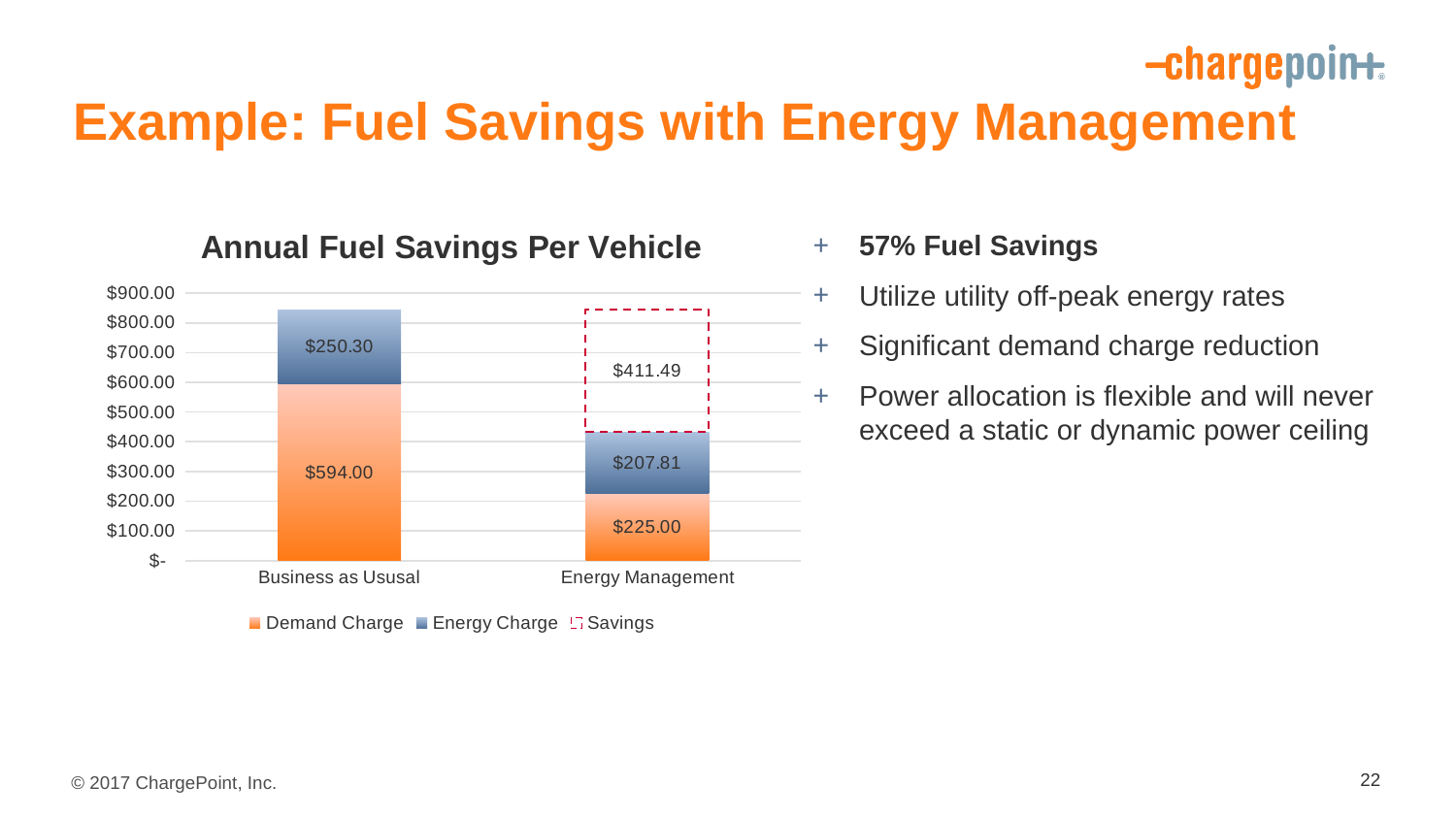
What is the total of the Demand Charge and Energy Charge segments for Energy Management? $432.81 What is the Demand Charge value for Energy Management? $225.00 What is the total of the Demand Charge and Energy Charge segments for Business as Usual? $844.30 Which category has the larger Demand Charge, Business as Usual or Energy Management? Business as Ususal What is the Savings value shown for Energy Management? $411.49 What kind of chart is the Annual Fuel Savings Per Vehicle chart? Stacked bar chart What is the Energy Charge value for Energy Management? $207.81 What is the Demand Charge value for Business as Usual in the Annual Fuel Savings Per Vehicle chart? $594.00 What is the Energy Charge value for Business as Usual? $250.30 How many series does the legend list in the Annual Fuel Savings Per Vehicle chart? 3 What is the difference between the Energy Charge for Business as Usual and the Energy Charge for Energy Management? $42.49 What is the difference between the Demand Charge for Business as Usual and the Demand Charge for Energy Management? $369.00